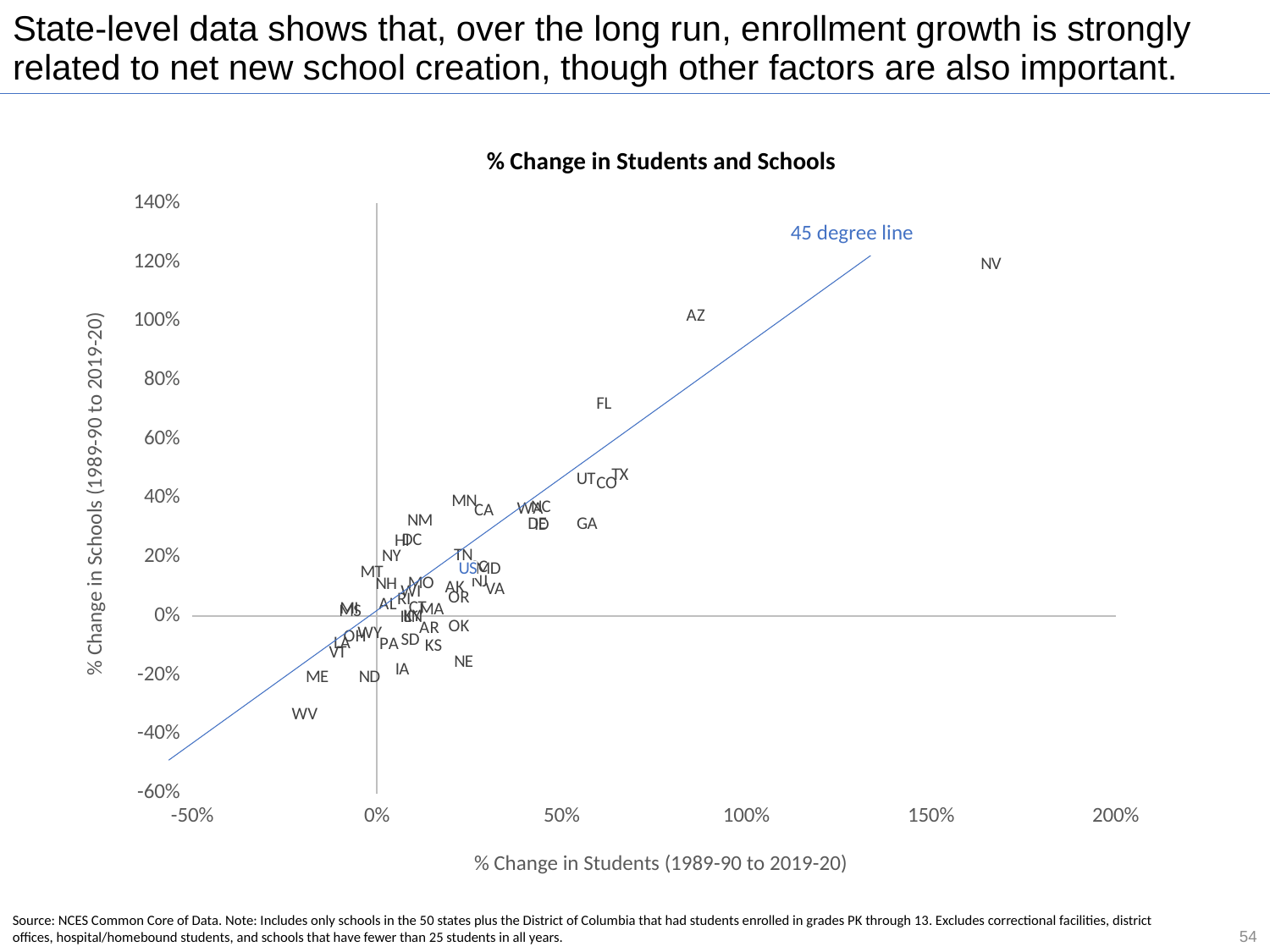
Which has a larger % change in students, NV or AZ? NV Is the % change in students for AZ greater or less than 50%? greater Is the % change in schools for FL greater or less than 60%? greater Is the % change in schools for NV greater or less than 100%? greater Which has a higher % change in schools, AZ or FL? AZ Which state has the highest % change in schools? NV What is the title of the chart? % Change in Students and Schools What is the label of the x axis? % Change in Students (1989-90 to 2019-20) Which state has the lowest % change in schools? WV Which state has the highest % change in students? NV What kind of chart is shown on the slide? scatter chart